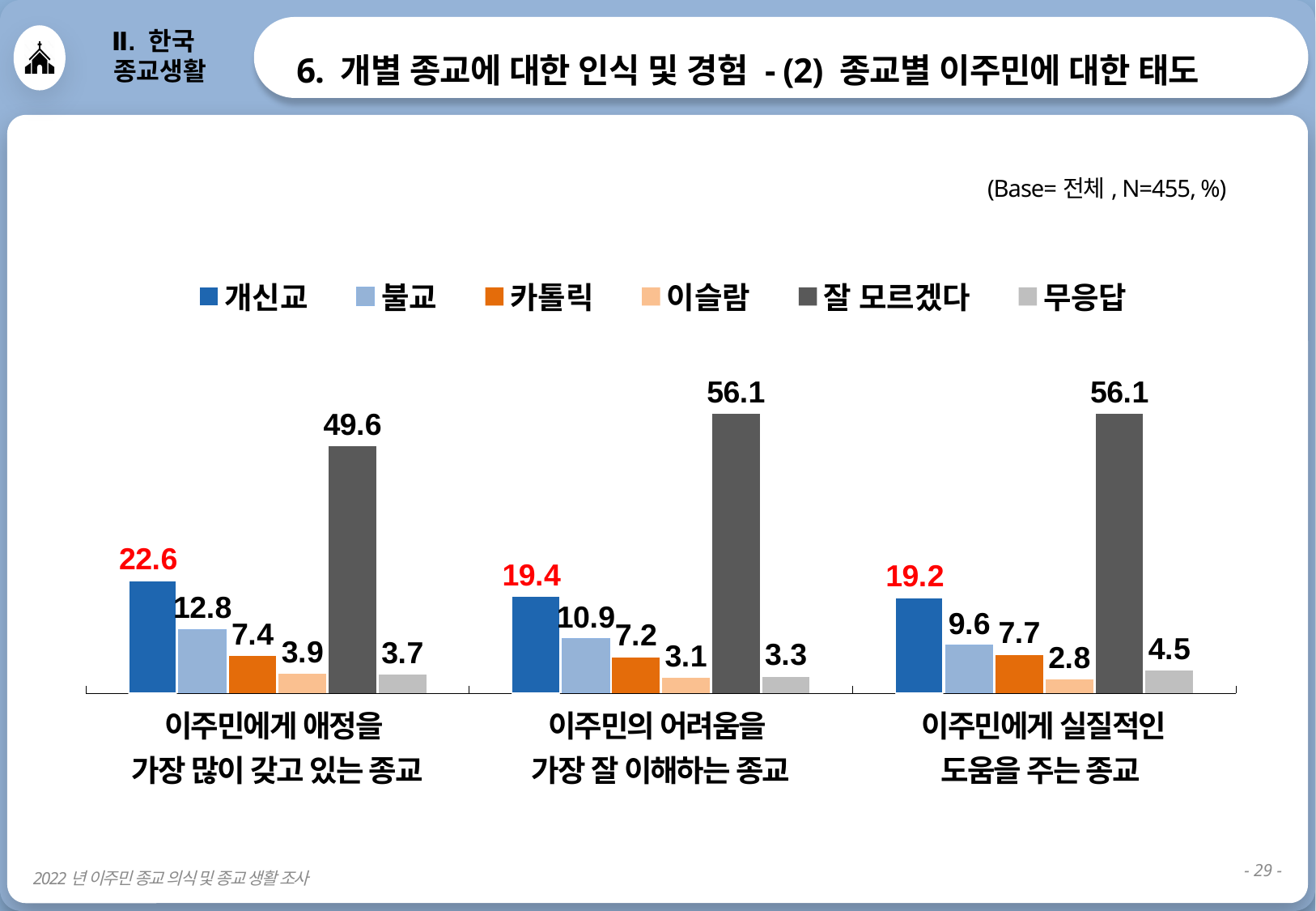
How many series does the legend list? 6 Which series has the lowest value in the category 이주민에게 실질적인 도움을 주는 종교? 이슬람 Which series has the highest value in the category 이주민의 어려움을 가장 잘 이해하는 종교? 잘 모르겠다 What is the value for 불교 in the category 이주민의 어려움을 가장 잘 이해하는 종교? 10.9 How many categories are shown on the x axis of the chart? 3 What is the difference between the 개신교 and 불교 values in the category 이주민에게 애정을 가장 많이 갖고 있는 종교? 9.8 What is the value for 카톨릭 in the category 이주민에게 실질적인 도움을 주는 종교? 7.7 What is the value for 잘 모르겠다 in the category 이주민에게 애정을 가장 많이 갖고 있는 종교? 49.6 What is the value for 개신교 in the category 이주민에게 애정을 가장 많이 갖고 있는 종교? 22.6 What kind of chart is shown on the slide? bar chart What is the value for 무응답 in the category 이주민에게 실질적인 도움을 주는 종교? 4.5 Which is larger: the 개신교 value for 이주민의 어려움을 가장 잘 이해하는 종교 or the 개신교 value for 이주민에게 실질적인 도움을 주는 종교? 이주민의 어려움을 가장 잘 이해하는 종교